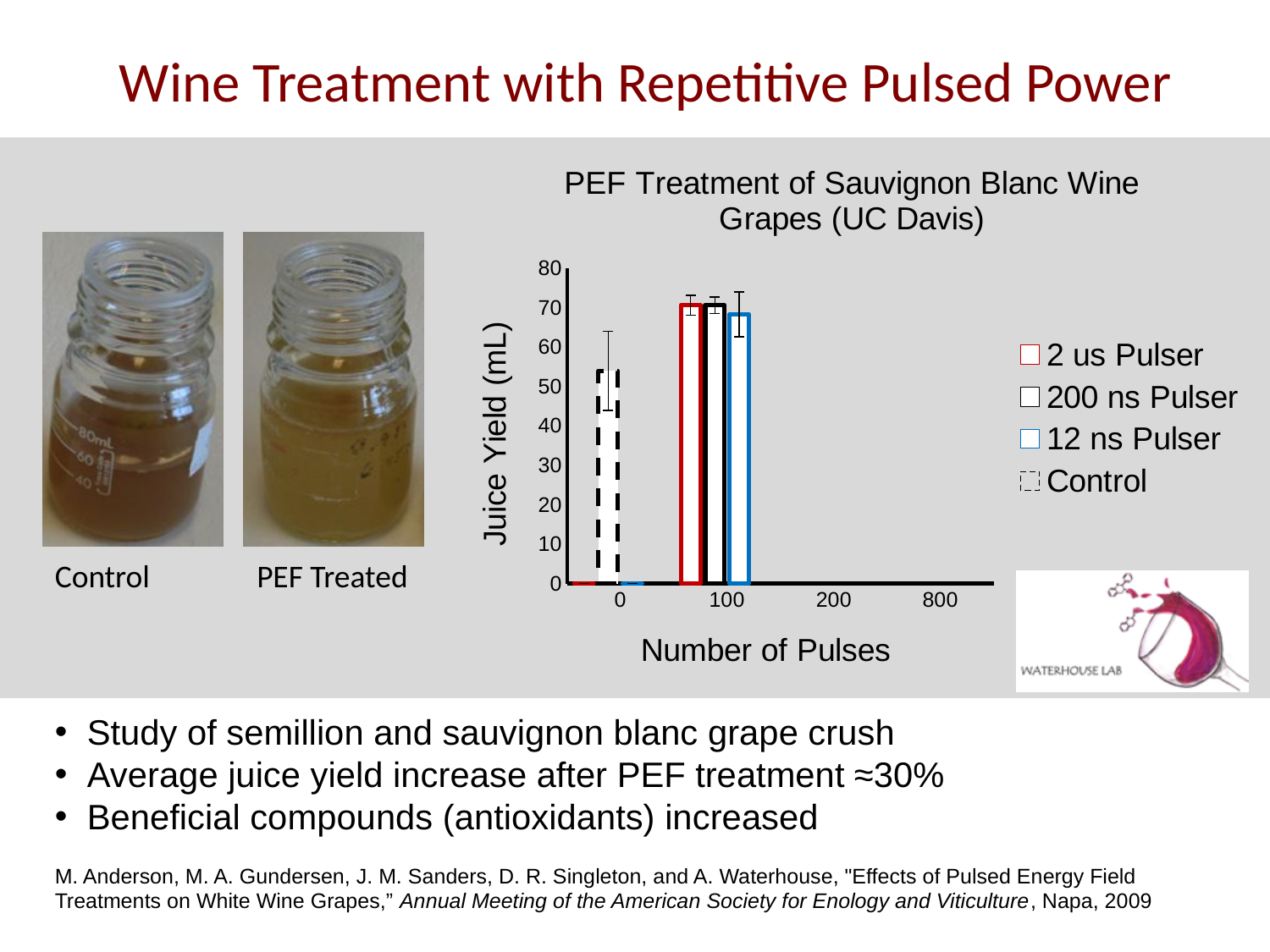
What is the title of the chart? PEF Treatment of Sauvignon Blanc Wine Grapes (UC Davis) What kind of chart is shown on the slide? bar chart Which series has the lowest juice yield on the chart? Control Is the juice yield for the 12 ns Pulser at 100 pulses greater or less than 50? greater What is the label on the vertical axis of the chart? Juice Yield (mL) Is the juice yield for the Control bar at 0 pulses greater or less than 60? less Is the juice yield for the Control bar at 0 pulses greater or less than 40? greater Which has the larger juice yield: the Control bar at 0 pulses or the 2 us Pulser bar at 100 pulses? 2 us Pulser at 100 pulses How many tick labels are shown on the Number of Pulses axis? 4 Which has the larger juice yield: the Control bar at 0 pulses or the 200 ns Pulser bar at 100 pulses? 200 ns Pulser at 100 pulses How many series does the chart legend list? 4